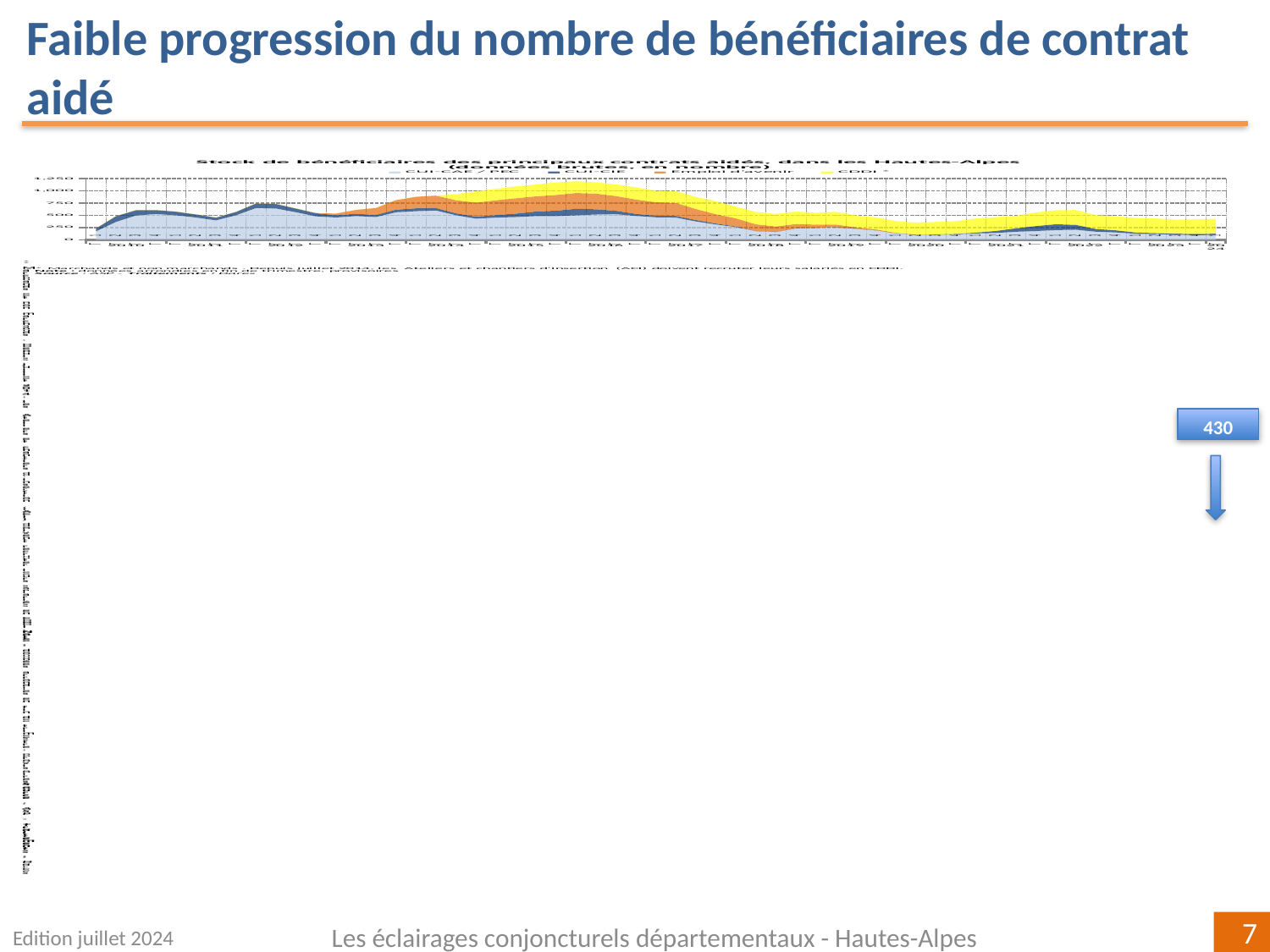
How many series does the chart legend list? 4 Is the total stock of beneficiaries at its peak around 2015 greater or less than 750? greater Is the total stock of beneficiaries around 2020 greater or less than 500? less Does the total stock of beneficiaries rise or fall between 2015 and 2020? fall What kind of chart is shown on the slide? area chart Does the total stock of beneficiaries rise or fall between 2010 and 2015? rise What number is shown in the blue callout box to the right of the chart? 430 What is the title of the chart? Stock de bénéficiaires des principaux contrats aidés, dans les Hautes-Alpes (données brutes, en nombre)